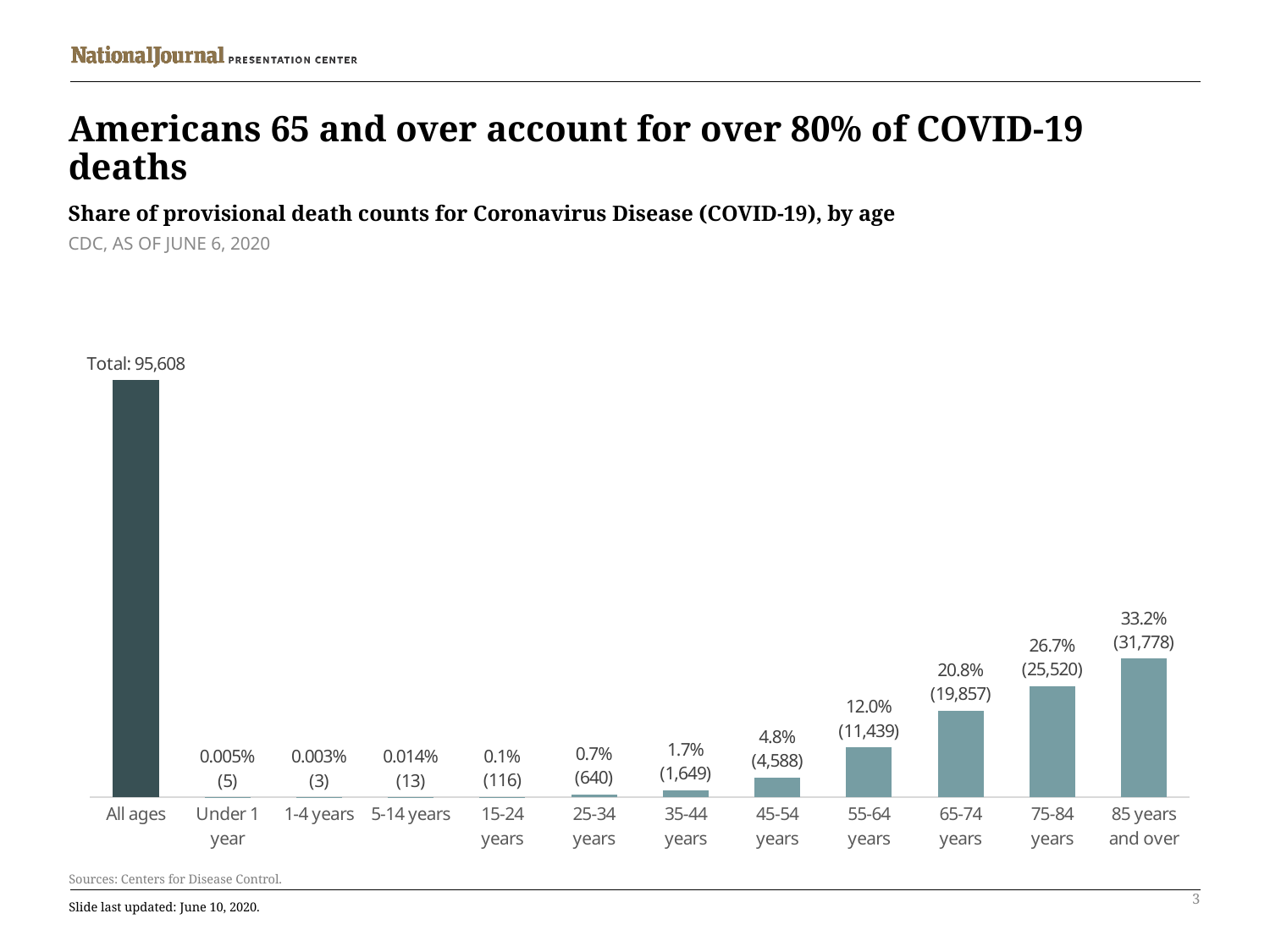
How many bars are shown on the chart, including the All ages bar? 12 What share of COVID-19 deaths is shown for the 85 years and over age group? 33.2% Which age group has the lowest share of deaths? 1-4 years What kind of chart is shown on the slide? Bar chart How many deaths are shown in parentheses for the 75-84 years age group? 25,520 What is the total death count shown above the All ages bar? 95,608 How many more deaths are shown for the 75-84 years group than for the 65-74 years group? 5,663 What share of deaths is shown for the 55-64 years age group? 12.0% Which age group has a larger share of deaths, 35-44 years or 45-54 years? 45-54 years From the 15-24 years group to the 85 years and over group, do the shares rise or fall? Rise By how many percentage points does the share for 85 years and over exceed the share for 75-84 years? 6.5 Excluding the All ages bar, which age group has the highest share of deaths? 85 years and over